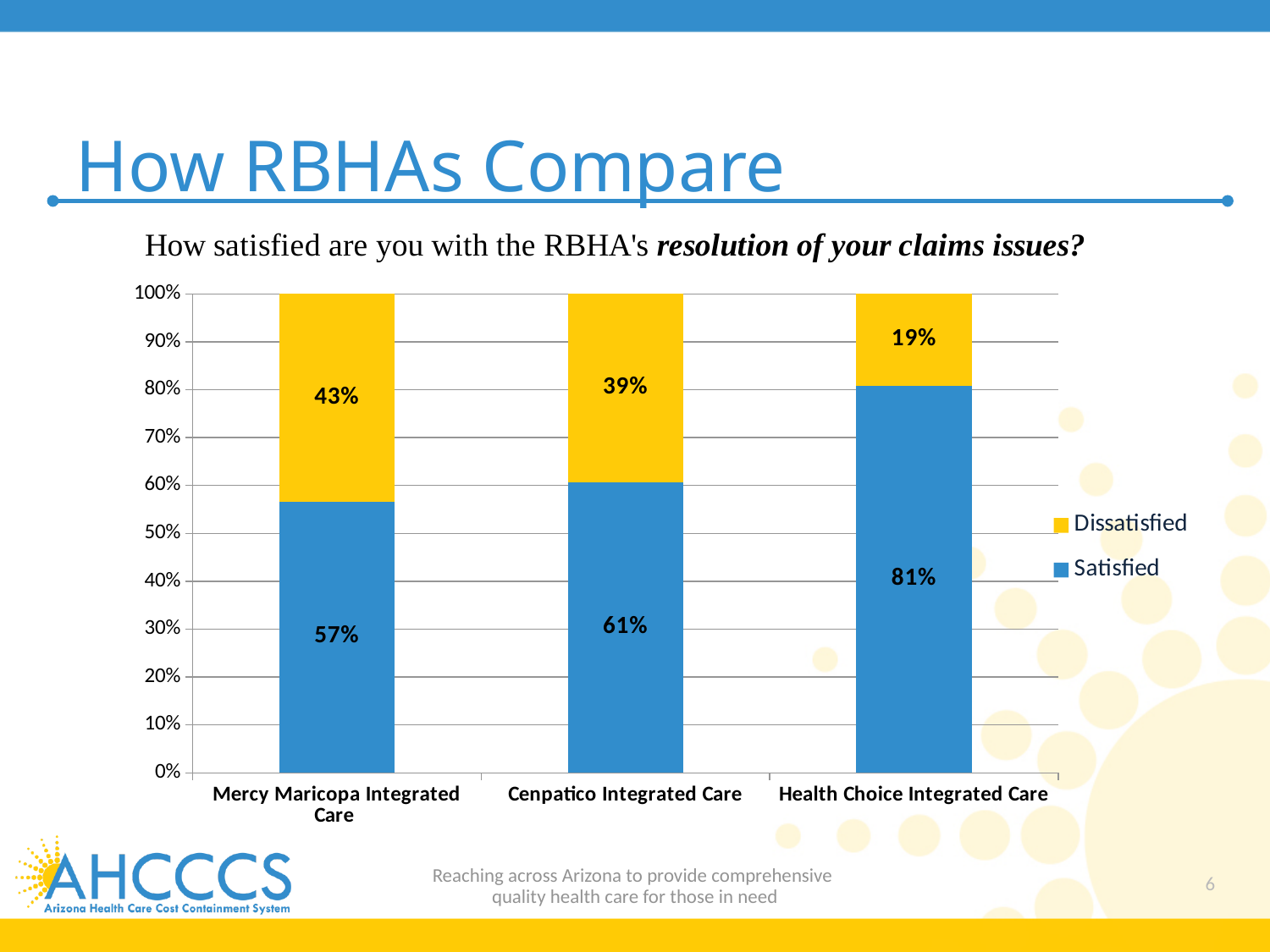
Which RBHA has the lowest Dissatisfied percentage? Health Choice Integrated Care Which RBHA has the highest Satisfied percentage? Health Choice Integrated Care What is the Dissatisfied value for Mercy Maricopa Integrated Care? 43% Which has a larger Dissatisfied percentage, Mercy Maricopa Integrated Care or Cenpatico Integrated Care? Mercy Maricopa Integrated Care What is the Satisfied value for Cenpatico Integrated Care? 61% How many RBHAs are shown on the x axis of the chart? 3 How many series does the chart legend list? 2 What is the total of the stacked bar for Cenpatico Integrated Care? 100% Which colour represents the Dissatisfied series in the chart? Yellow What percentage of respondents were satisfied with Health Choice Integrated Care's resolution of claims issues? 81% What type of chart is shown on the slide? Stacked bar chart What is the difference between the Satisfied percentages for Health Choice Integrated Care and Mercy Maricopa Integrated Care? 24%